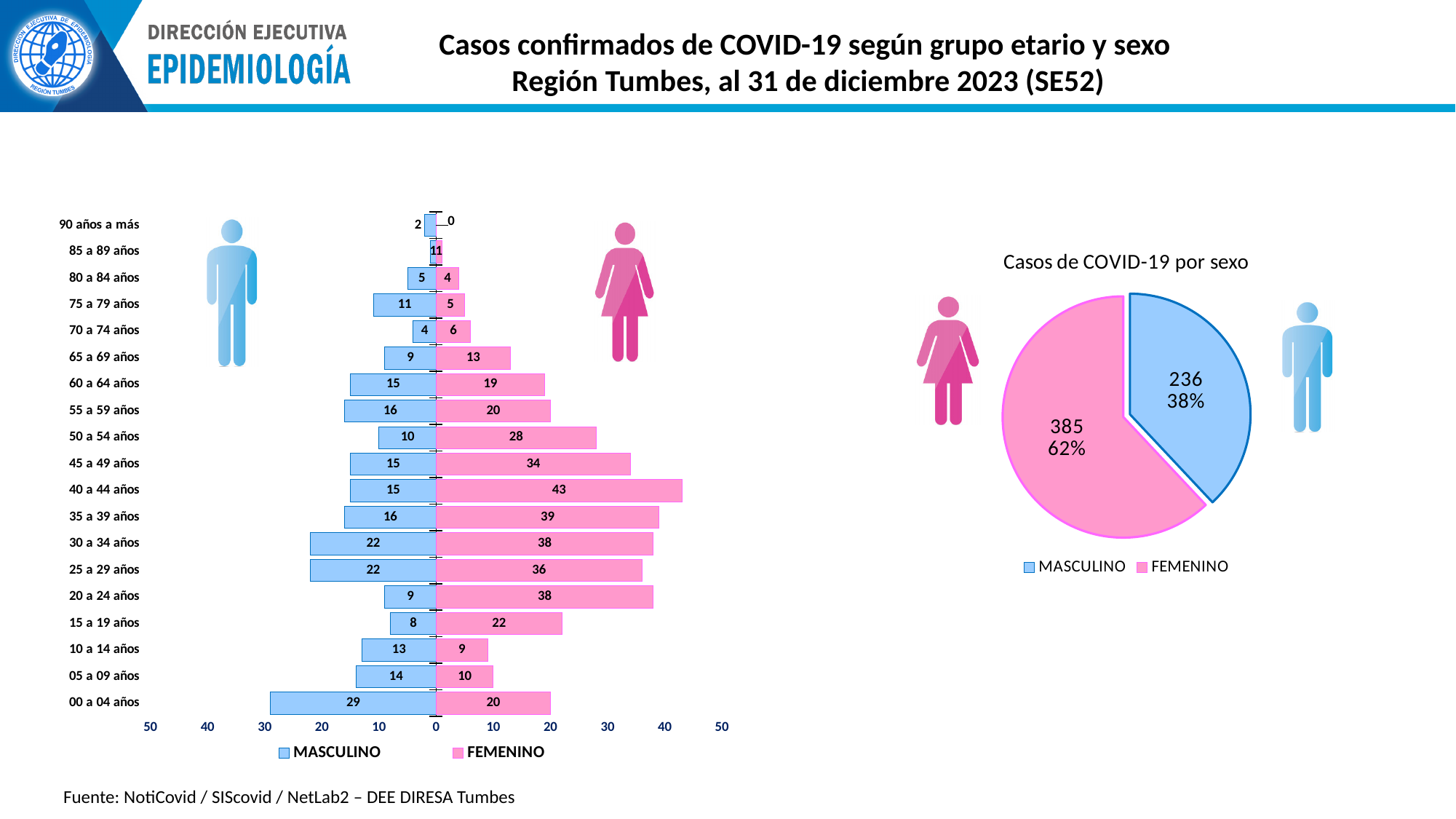
In the age-sex pyramid chart on the left, what is the difference between FEMENINO and MASCULINO cases in the 20 a 24 años group? 29 In the age-sex pyramid chart on the left, how many FEMENINO cases are in the 40 a 44 años group? 43 What kind of chart is the 'Casos de COVID-19 por sexo' chart on the right? Pie chart In the 'Casos de COVID-19 por sexo' pie chart, what is the total number of cases across both slices? 621 In the age-sex pyramid chart on the left, how many series does the legend list? 2 In the 'Casos de COVID-19 por sexo' pie chart, how many MASCULINO cases are shown? 236 In the age-sex pyramid chart on the left, which age group has the highest number of FEMENINO cases? 40 a 44 años In the age-sex pyramid chart on the left, how many MASCULINO cases are in the 00 a 04 años group? 29 In the age-sex pyramid chart on the left, which age group has the highest number of MASCULINO cases? 00 a 04 años In the 'Casos de COVID-19 por sexo' pie chart, what share of cases is FEMENINO? 62% In the age-sex pyramid chart on the left, which is larger in the 10 a 14 años group, MASCULINO or FEMENINO? MASCULINO In the age-sex pyramid chart on the left, how many age groups are shown? 19